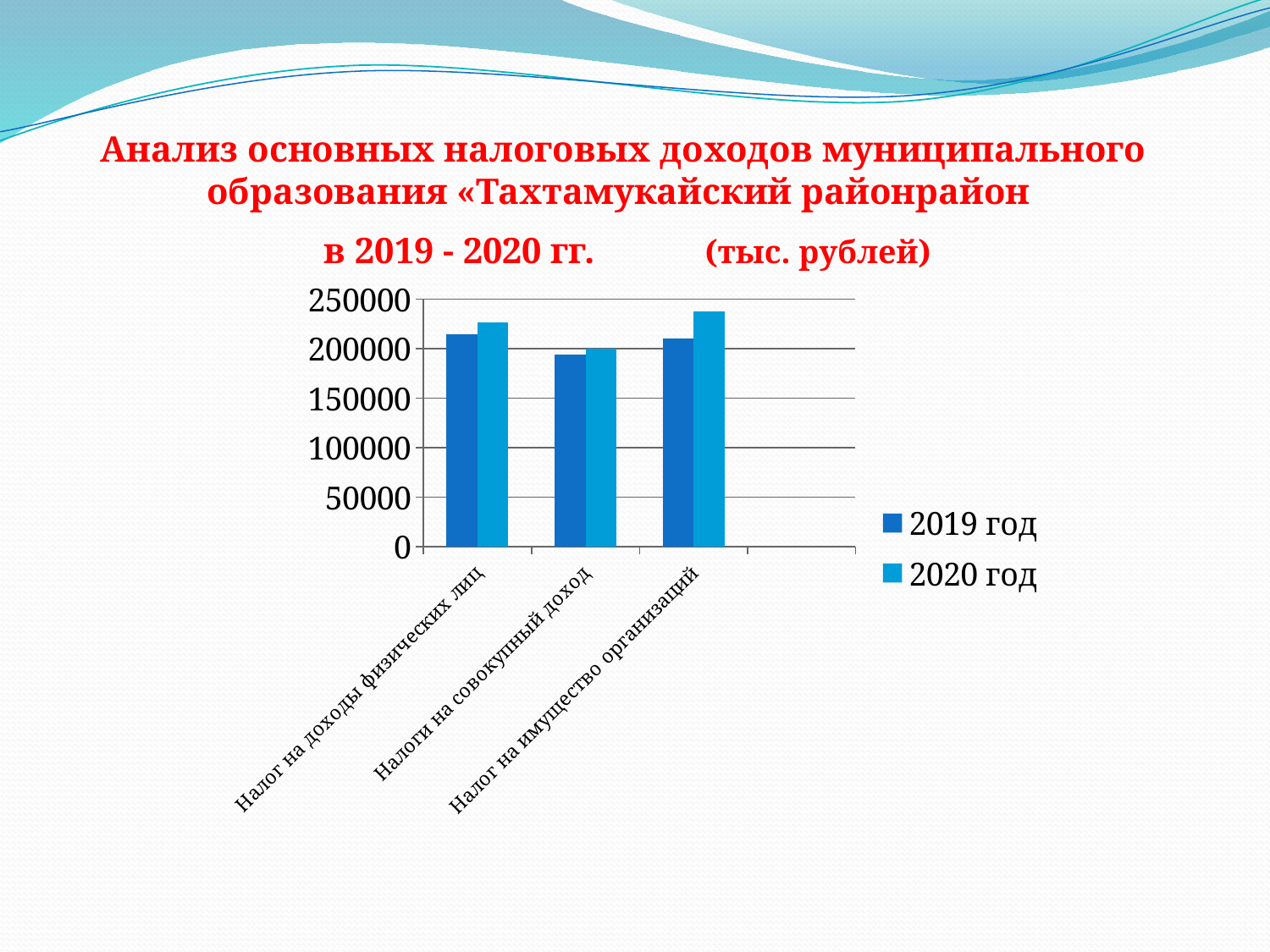
Which category has the highest value for 2020 год? Налог на имущество организаций What are the two series listed in the chart legend? 2019 год and 2020 год Is the value for Налог на доходы физических лиц in 2019 год greater or less than 200000? greater How many series does the chart legend list? 2 For 2020 год, which is larger: Налог на доходы физических лиц or Налоги на совокупный доход? Налог на доходы физических лиц Is the value for Налог на имущество организаций in 2020 год greater or less than 250000? less For Налог на имущество организаций, is the 2020 год value higher or lower than the 2019 год value? higher How many categories are shown on the x axis of the chart? 3 What kind of chart is shown on the slide? bar chart Which category has the lowest value for 2019 год? Налоги на совокупный доход In what units are the values on the chart given, according to the title? тыс. рублей Is the value for Налоги на совокупный доход in 2019 год greater or less than 200000? less